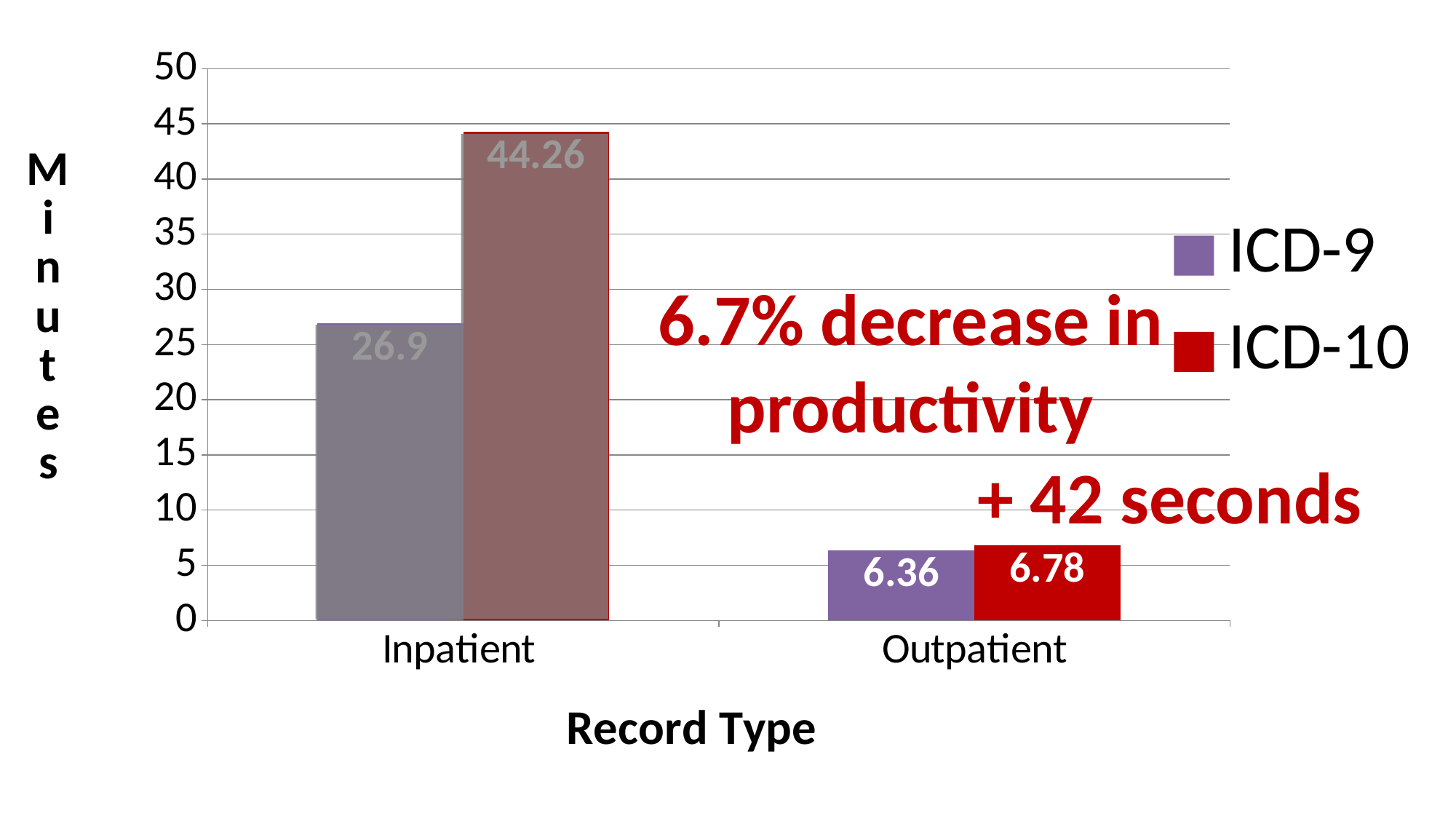
Is the ICD-10 value for Inpatient greater or less than 40? greater What is the ICD-10 value for Inpatient? 44.26 Which record type has the highest ICD-10 value? Inpatient How many record types are shown on the x axis? 2 What is the difference between the ICD-10 and ICD-9 values for Inpatient? 17.36 What is the ICD-9 value for Inpatient? 26.9 Which record type has the lowest ICD-9 value? Outpatient Which is larger for Outpatient, the ICD-9 value or the ICD-10 value? ICD-10 What kind of chart is shown on the slide? bar chart How many series does the legend list? 2 What is the ICD-9 value for Outpatient? 6.36 What is the ICD-10 value for Outpatient? 6.78